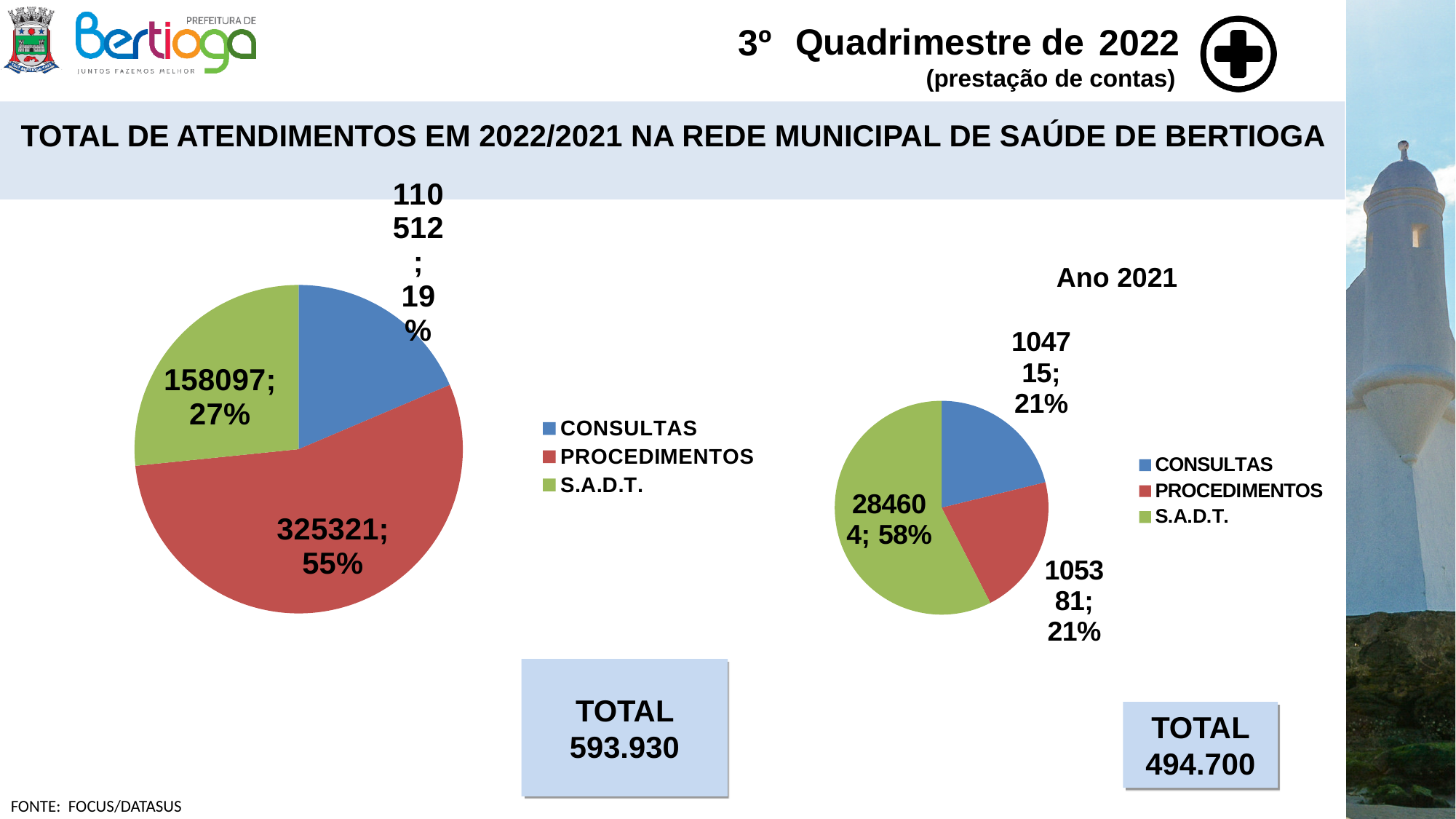
In the right pie chart titled Ano 2021, is the slice for S.A.D.T. larger or smaller than the slice for CONSULTAS? larger How many series does the legend of the right pie chart titled Ano 2021 list? 3 In the right pie chart titled Ano 2021, which category has the largest slice? S.A.D.T. In the right pie chart titled Ano 2021, what is the value shown for S.A.D.T.? 284604; 58% In the left pie chart, which category has the smallest slice? CONSULTAS In the right pie chart titled Ano 2021, what share of the pie does CONSULTAS represent? 21% What kind of chart is the left chart on the slide? pie chart In the left pie chart, what is the value shown for CONSULTAS? 110512; 19% In the left pie chart, which category has the largest slice? PROCEDIMENTOS In the left pie chart, what is the difference between the PROCEDIMENTOS value and the S.A.D.T. value? 167224 In the left pie chart, what is the value shown for PROCEDIMENTOS? 325321; 55% In the left pie chart, what share of the pie does S.A.D.T. represent? 27%